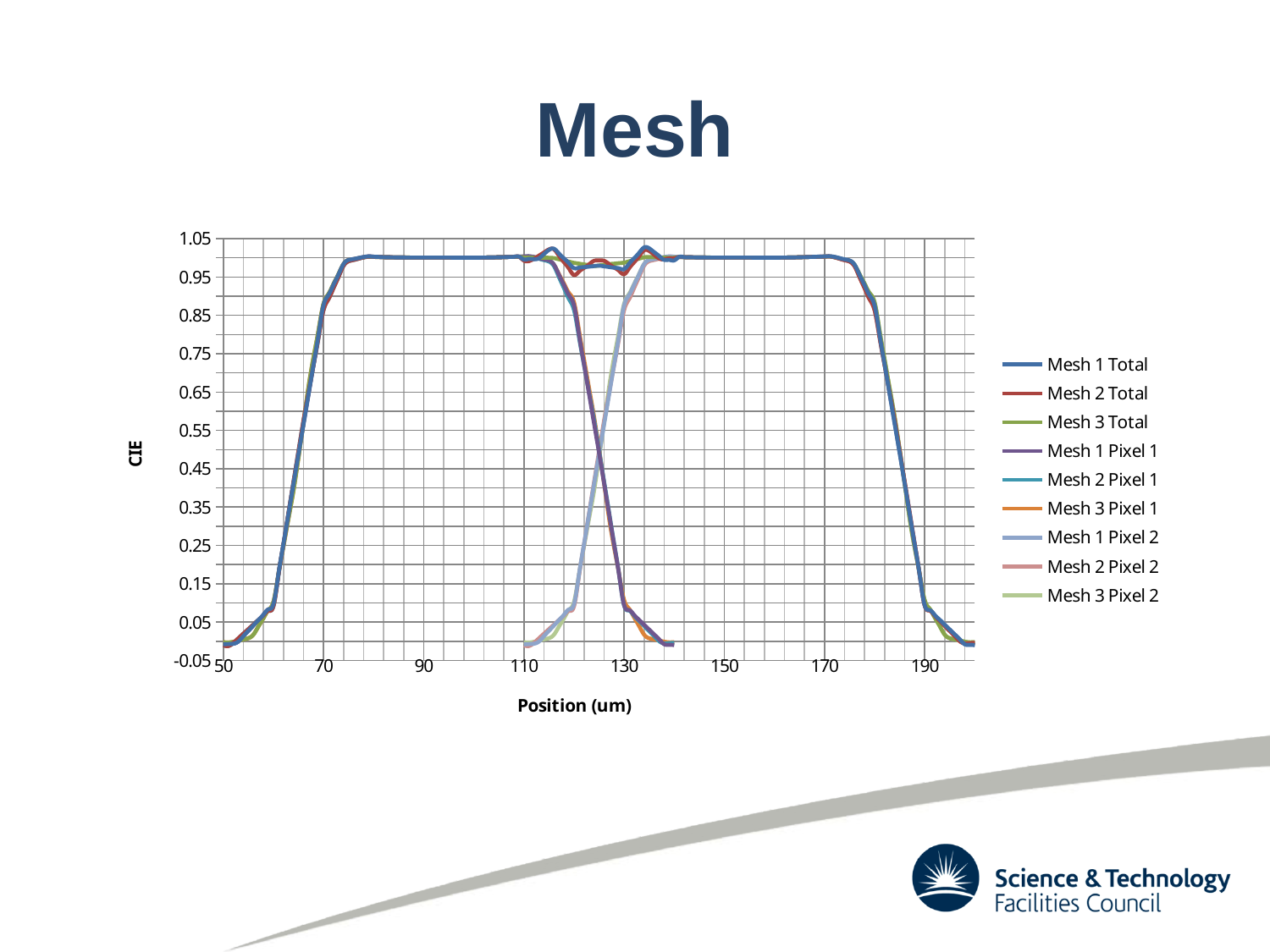
Does Mesh 1 Pixel 2 rise or fall between positions 120 and 130? rise How many series does the legend list? 9 Is the value of Mesh 1 Pixel 1 at position 135 greater or less than 0.25? less Does Mesh 1 Total rise or fall between positions 180 and 190? fall Is the value of Mesh 1 Pixel 2 at position 135 greater or less than 0.85? greater At position 120, which is higher: Mesh 1 Pixel 1 or Mesh 1 Pixel 2? Mesh 1 Pixel 1 What kind of chart is shown on the slide? line chart Is the value of Mesh 1 Total at position 90 greater or less than 0.85? greater What is the title of the x axis? Position (um) Does Mesh 1 Pixel 1 rise or fall between positions 120 and 130? fall What is the title of the y axis? CIE